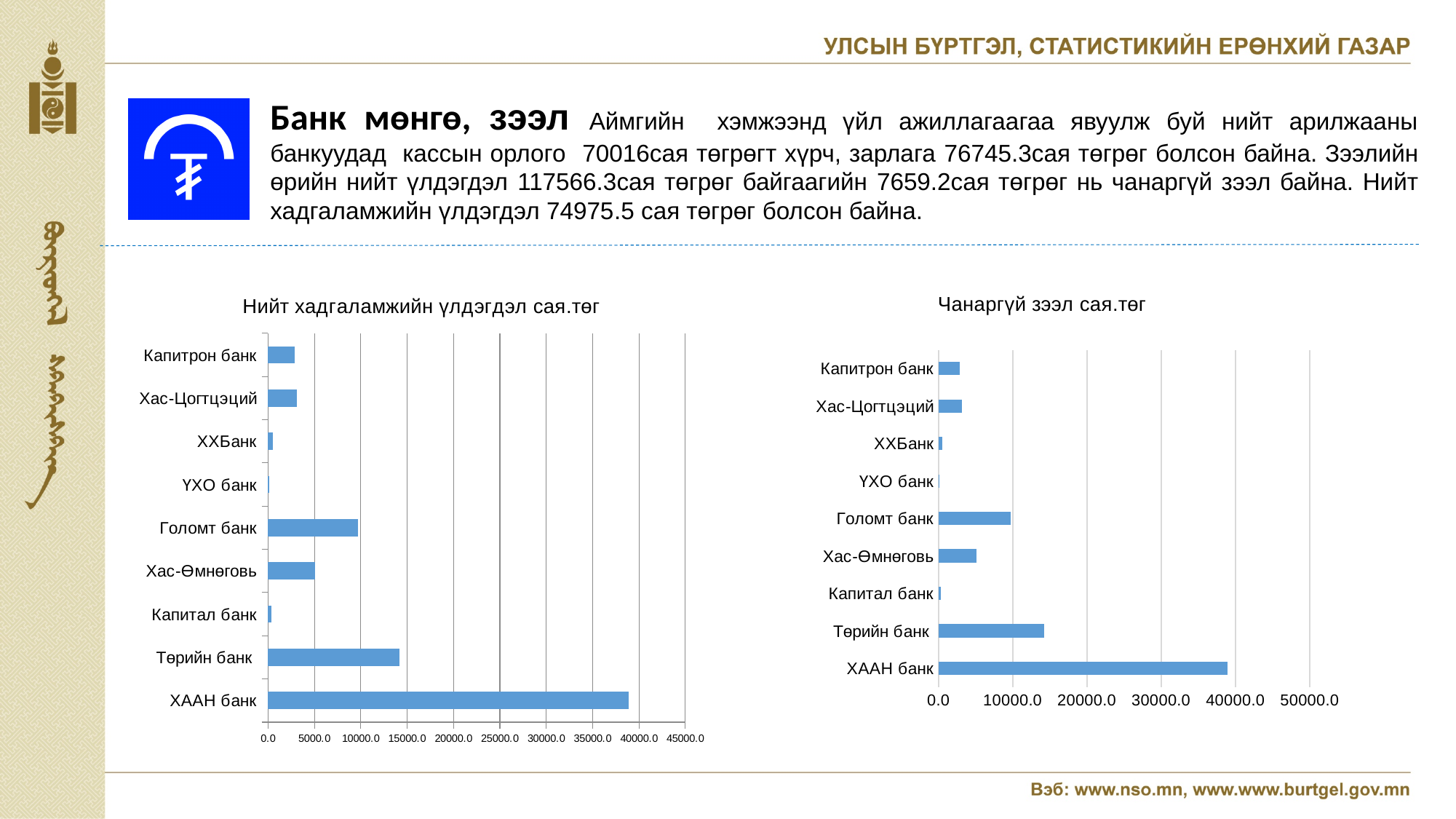
In the chart titled "Чанаргүй зээл сая.төг", which is larger, the value for Капитрон банк or the value for Төрийн банк? Төрийн банк In the chart titled "Нийт хадгаламжийн үлдэгдэл сая.төг", is the value for Төрийн банк greater or less than 15000.0? less In the chart titled "Чанаргүй зээл сая.төг", is the value for ХААН банк greater or less than 30000.0? greater In the chart titled "Чанаргүй зээл сая.төг", is the value for Хас-Өмнөговь greater or less than 10000.0? less In the chart titled "Нийт хадгаламжийн үлдэгдэл сая.төг", which bank has the lowest value? ҮХО банк In the chart titled "Нийт хадгаламжийн үлдэгдэл сая.төг", which is larger, the value for Төрийн банк or the value for Голомт банк? Төрийн банк In the chart titled "Чанаргүй зээл сая.төг", which bank has the highest value? ХААН банк What kind of chart is the chart titled "Нийт хадгаламжийн үлдэгдэл сая.төг"? bar chart How many banks are shown in the chart titled "Чанаргүй зээл сая.төг"? 9 In the chart titled "Нийт хадгаламжийн үлдэгдэл сая.төг", which bank has the highest value? ХААН банк How many banks are shown in the chart titled "Нийт хадгаламжийн үлдэгдэл сая.төг"? 9